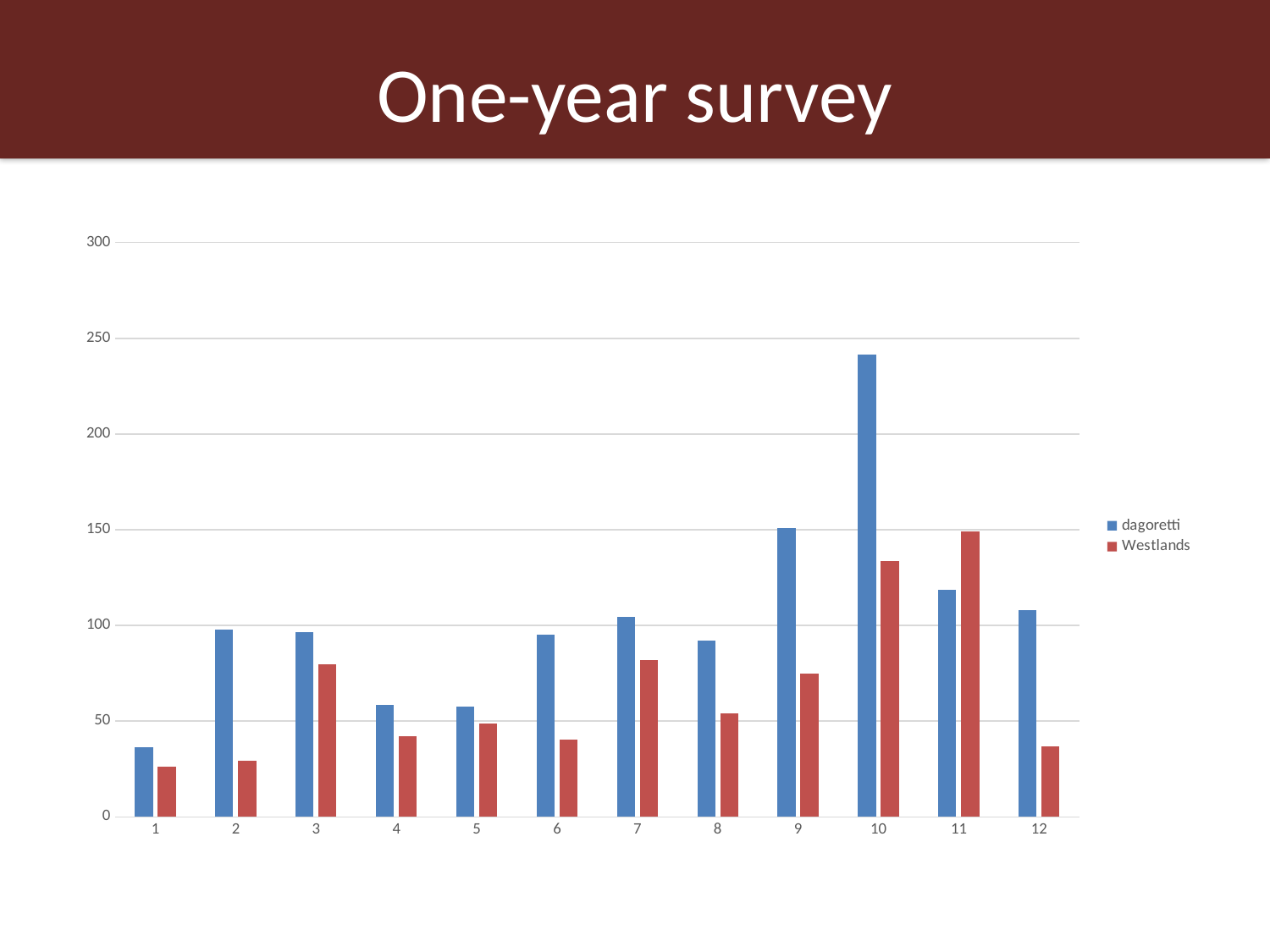
How many series does the legend list? 2 What is the title of the slide containing the chart? One-year survey Which category has the highest value for dagoretti? 10 Is the value for Westlands at category 3 greater or less than 100? less What kind of chart is shown on the slide? bar chart Which category has the lowest value for dagoretti? 1 Is the value for dagoretti at category 10 greater or less than 200? greater Is the value for dagoretti at category 1 greater or less than 50? less How many categories are shown along the x axis? 12 Which category has the highest value for Westlands? 11 At category 11, which series has the larger value, dagoretti or Westlands? Westlands